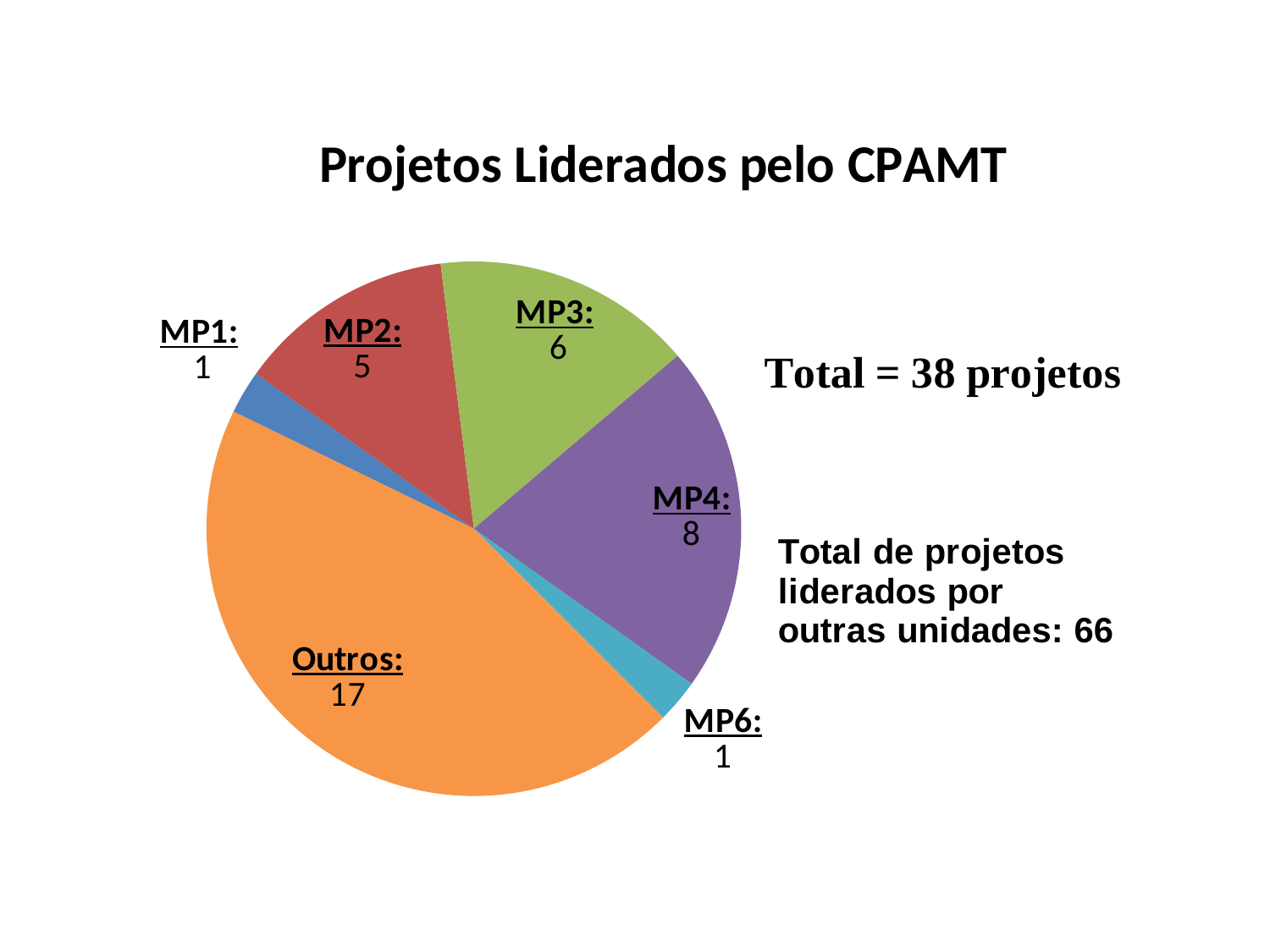
What is the total number of projects represented by the pie chart? 38 Which slice of the pie is the largest? Outros Which slices share the smallest value in the pie? MP1 and MP6 What is the value of the Outros slice? 17 What is the title of the chart? Projetos Liderados pelo CPAMT What colour is the Outros slice? orange How many projects are shown for MP4? 8 How many projects does the MP2 slice represent? 5 What is the difference between the values for MP4 and MP3? 2 What kind of chart is shown on the slide? pie chart Which is larger, the value for MP2 or the value for MP3? MP3 How many slices does the pie chart have? 6